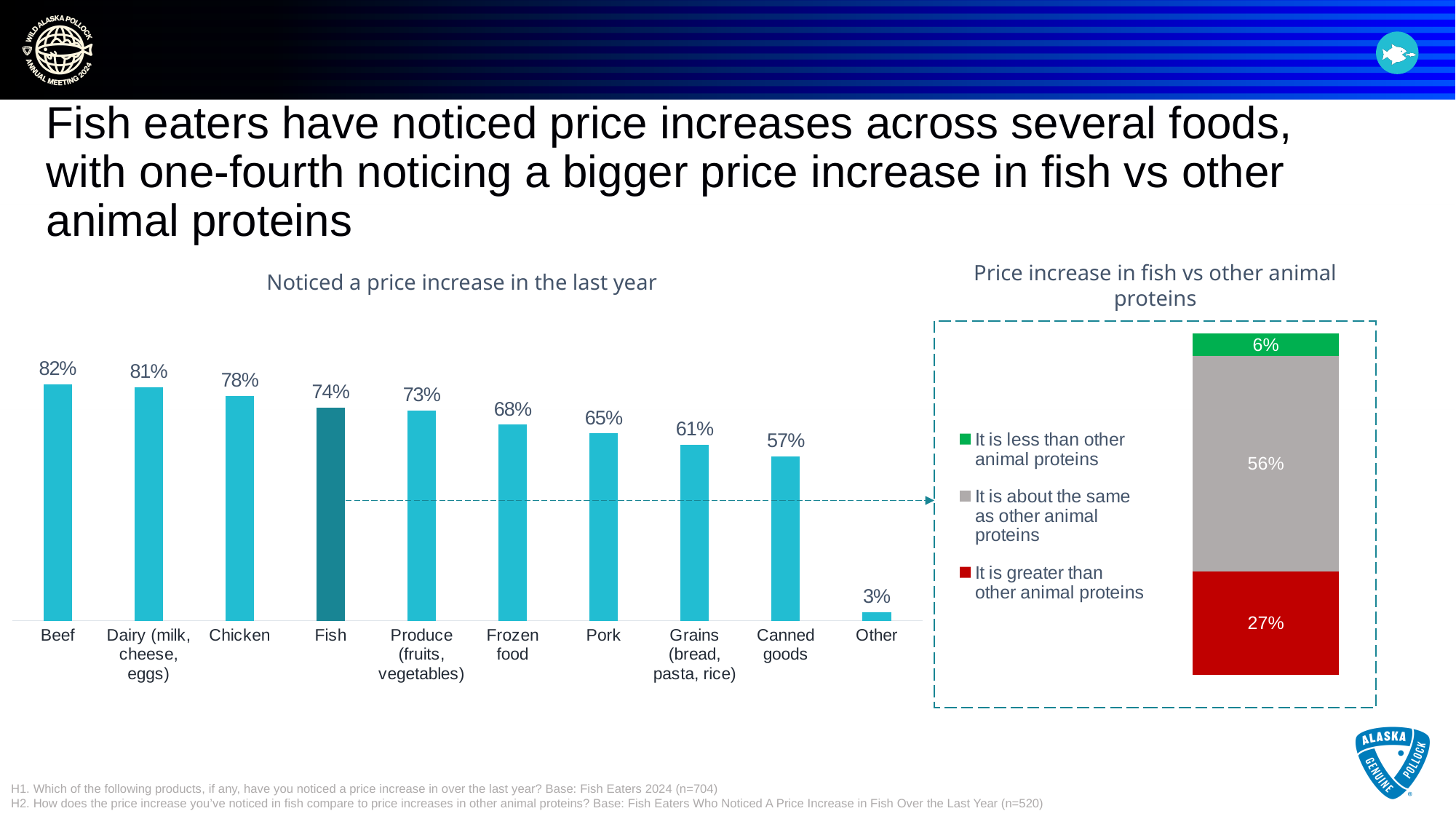
In the 'Price increase in fish vs other animal proteins' chart, what percentage said it is about the same as other animal proteins? 56% In the 'Price increase in fish vs other animal proteins' chart, what percentage said it is greater than other animal proteins? 27% In the 'Noticed a price increase in the last year' chart, what is the value for Canned goods? 57% In the 'Price increase in fish vs other animal proteins' chart, which colour represents 'It is less than other animal proteins'? Green In the 'Noticed a price increase in the last year' chart, which category has the highest value? Beef In the 'Noticed a price increase in the last year' chart, which category has the lowest value? Other In the 'Noticed a price increase in the last year' chart, what is the difference between the values for Beef and Fish? 8 percentage points What kind of chart is 'Noticed a price increase in the last year'? Bar chart How many series does the legend list in the 'Price increase in fish vs other animal proteins' chart? 3 In the 'Noticed a price increase in the last year' chart, which is larger, the value for Pork or the value for Grains (bread, pasta, rice)? Pork How many categories are shown in the 'Noticed a price increase in the last year' chart? 10 In the 'Noticed a price increase in the last year' chart, what percentage noticed a price increase for Fish? 74%